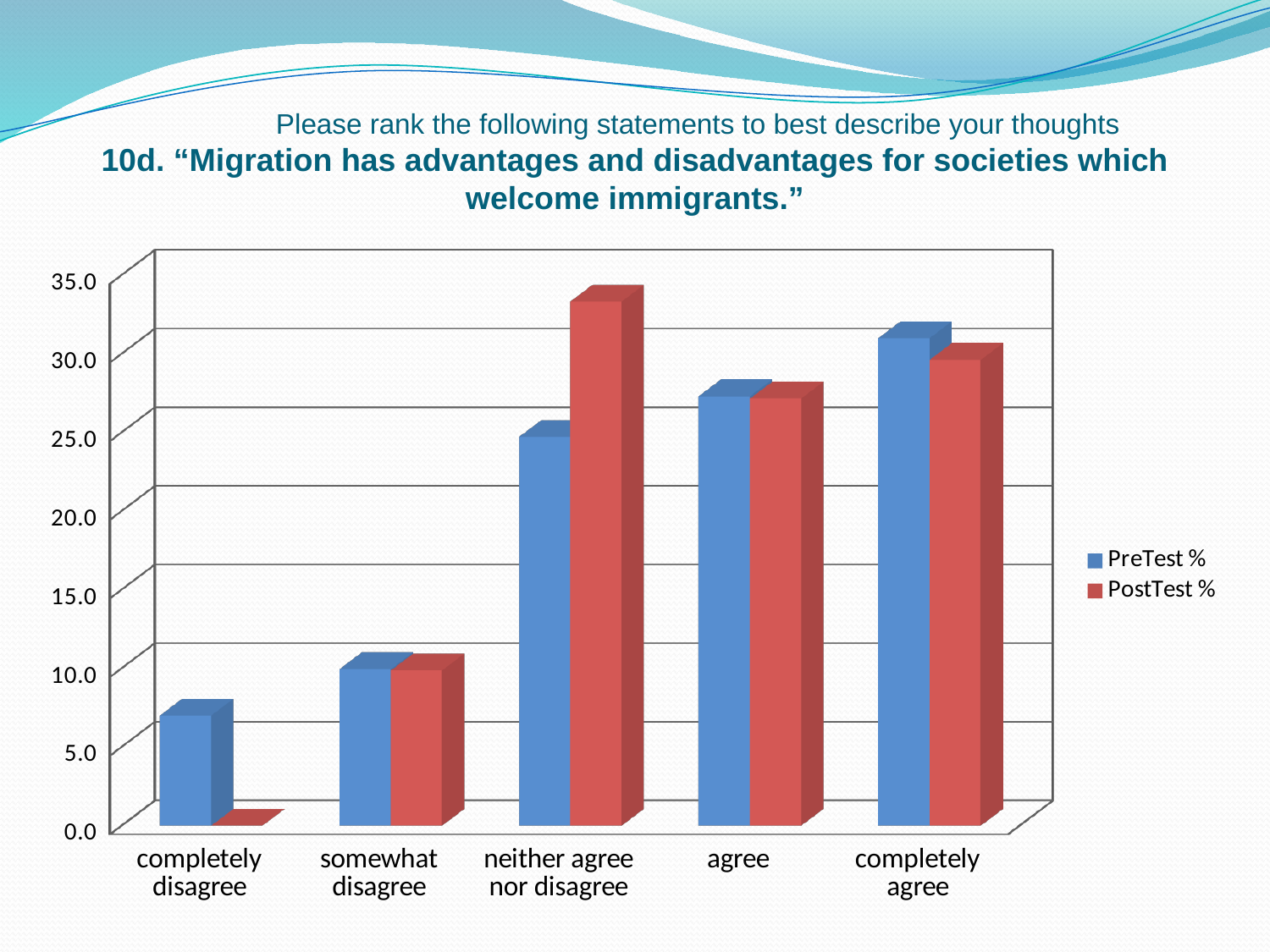
Is the PreTest % value for 'agree' greater or less than 25? greater Which category has the highest PostTest % value? neither agree nor disagree Which category has the highest PreTest % value? completely agree Which category has the lowest PreTest % value? completely disagree How many response categories are shown on the x axis? 5 Is the PostTest % value for 'neither agree nor disagree' greater or less than 30? greater What kind of chart is shown on the slide? bar chart For 'neither agree nor disagree', which is larger: PreTest % or PostTest %? PostTest % How many series does the legend list? 2 Which category has the lowest PostTest % value? completely disagree Which colour represents the PostTest % series in the legend? red Is the PreTest % value for 'completely disagree' greater or less than 5? greater